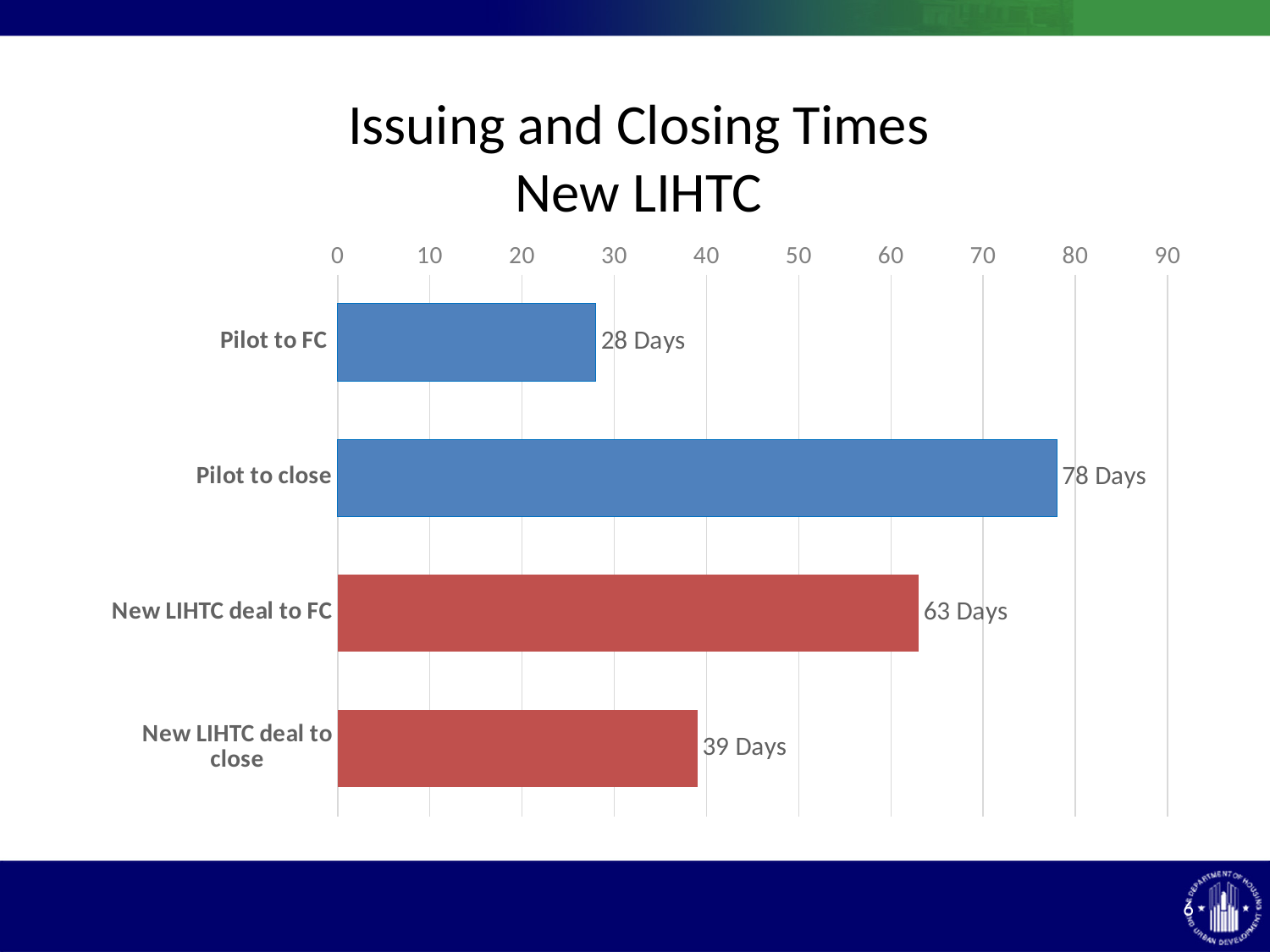
Which is larger, New LIHTC deal to FC or New LIHTC deal to close? New LIHTC deal to FC What is the value for New LIHTC deal to close? 39 Days What is the value for New LIHTC deal to FC? 63 Days What is the difference between New LIHTC deal to FC and Pilot to FC? 35 Days Is the value for Pilot to close greater or less than 70? greater Which category has the lowest value? Pilot to FC What is the value for Pilot to FC? 28 Days How many categories are shown in the chart? 4 Which category has the highest value? Pilot to close What kind of chart is shown on the slide? Bar chart What is the value for Pilot to close? 78 Days What is the difference between Pilot to close and New LIHTC deal to close? 39 Days